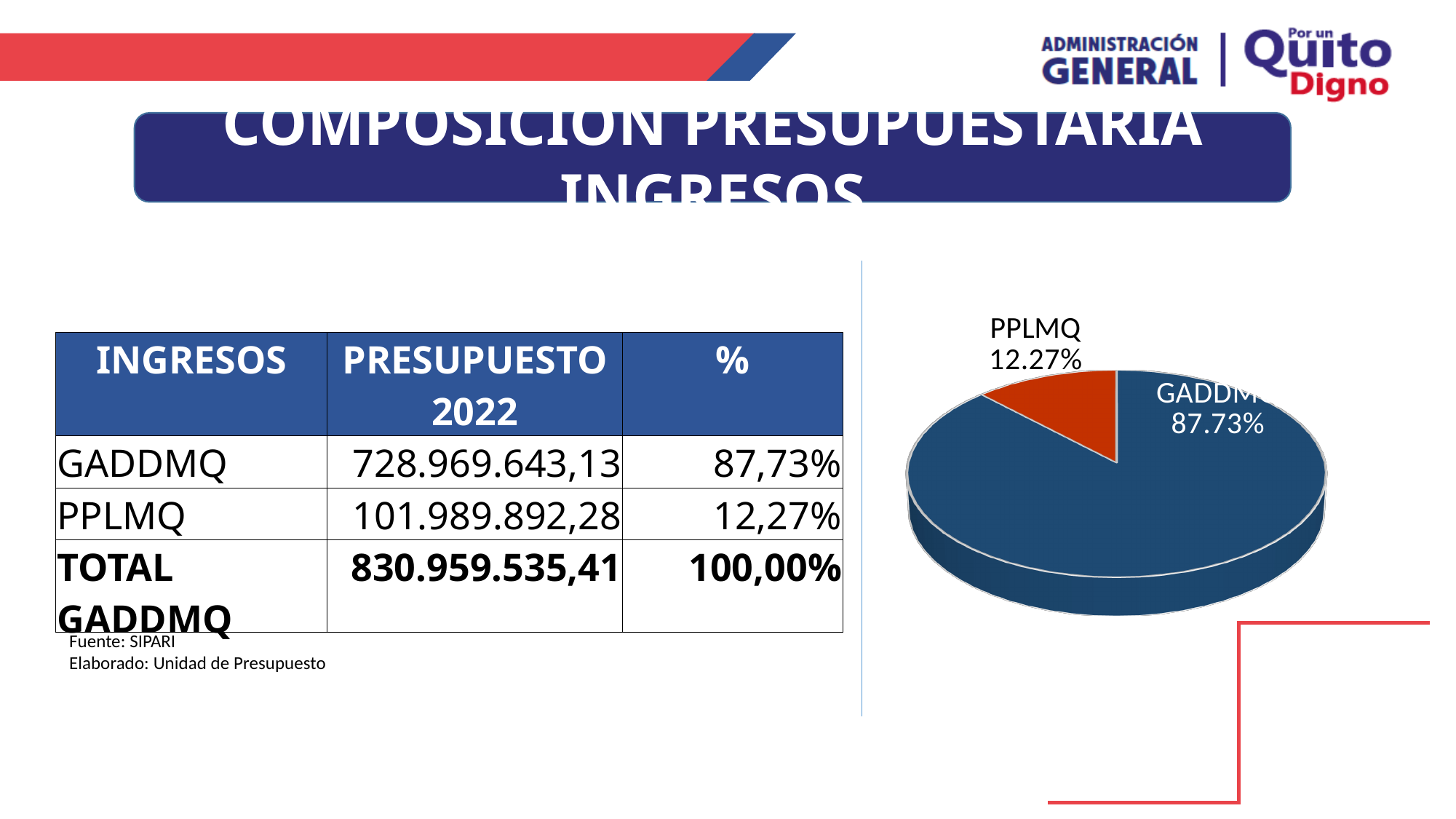
What colour is the PPLMQ slice in the pie chart? red How many slices does the pie chart have? 2 Which slice of the pie chart is the smallest? PPLMQ Which slice of the pie chart is the largest? GADDMQ What share of the pie does PPLMQ represent? 12.27% What colour is the GADDMQ slice in the pie chart? blue Is the share for PPLMQ in the pie chart greater or less than 50%? less What kind of chart is shown on the slide? pie chart Which is larger in the pie chart, GADDMQ or PPLMQ? GADDMQ What share of the pie does GADDMQ represent? 87.73% What is the difference in percentage points between the GADDMQ and PPLMQ slices? 75.46%